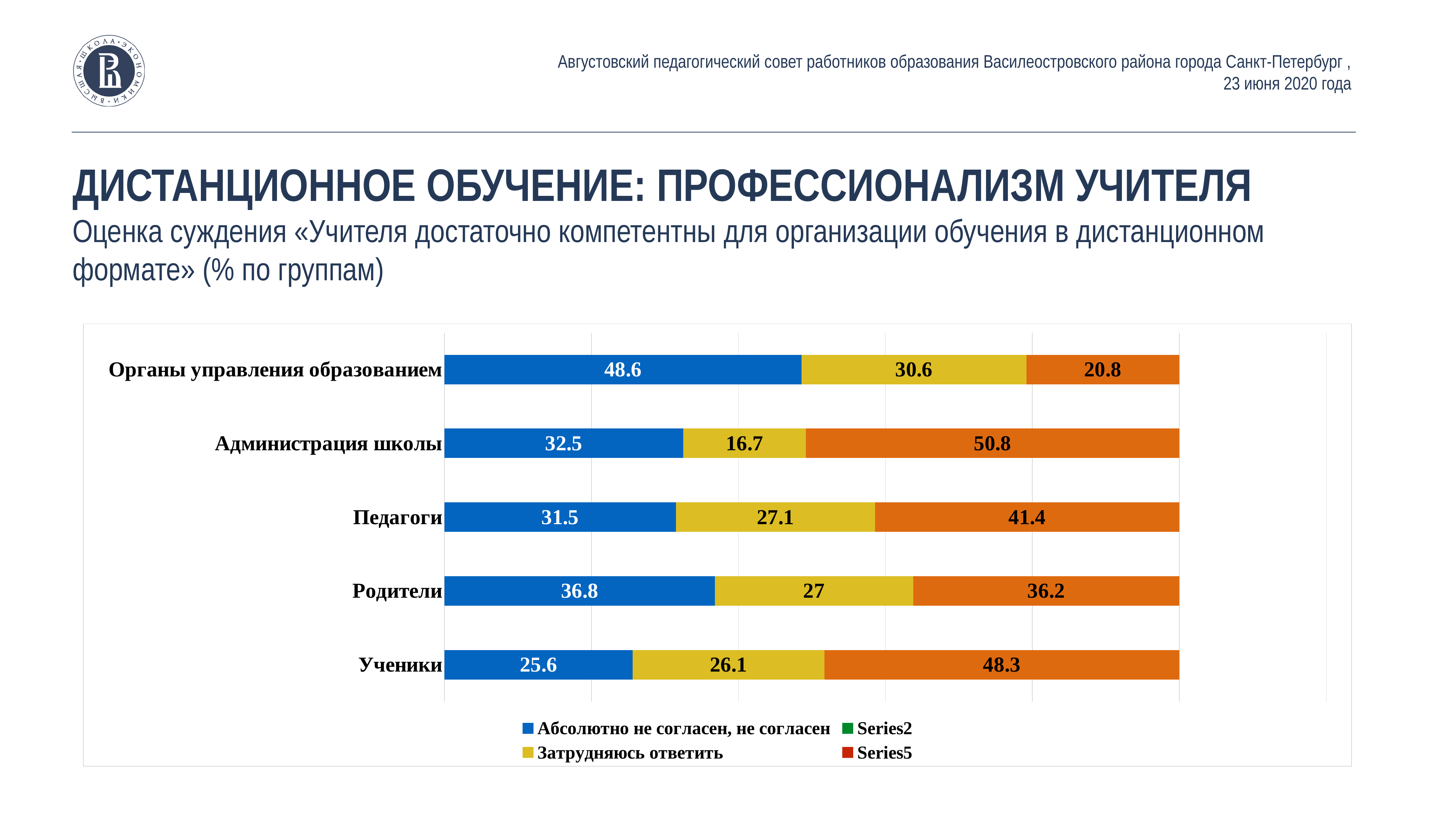
Which has the larger orange segment (Series5): «Педагоги» or «Родители»? Педагоги What is the difference between the «Абсолютно не согласен, не согласен» values for «Органы управления образованием» and «Ученики»? 23 What is the value of the orange segment (Series5) for «Ученики»? 48.3 Which group has the lowest value for «Абсолютно не согласен, не согласен»? Ученики Which group has the highest value for «Абсолютно не согласен, не согласен»? Органы управления образованием Which group has the lowest value in the orange segment (Series5)? Органы управления образованием How many series does the chart legend list? 4 What is the value of «Затрудняюсь ответить» for «Администрация школы»? 16.7 How many groups (categories) are shown on the chart? 5 What is the value of «Абсолютно не согласен, не согласен» for «Органы управления образованием»? 48.6 What is the total of the stacked bar for «Родители»? 100 What kind of chart is shown on the slide? Stacked bar chart